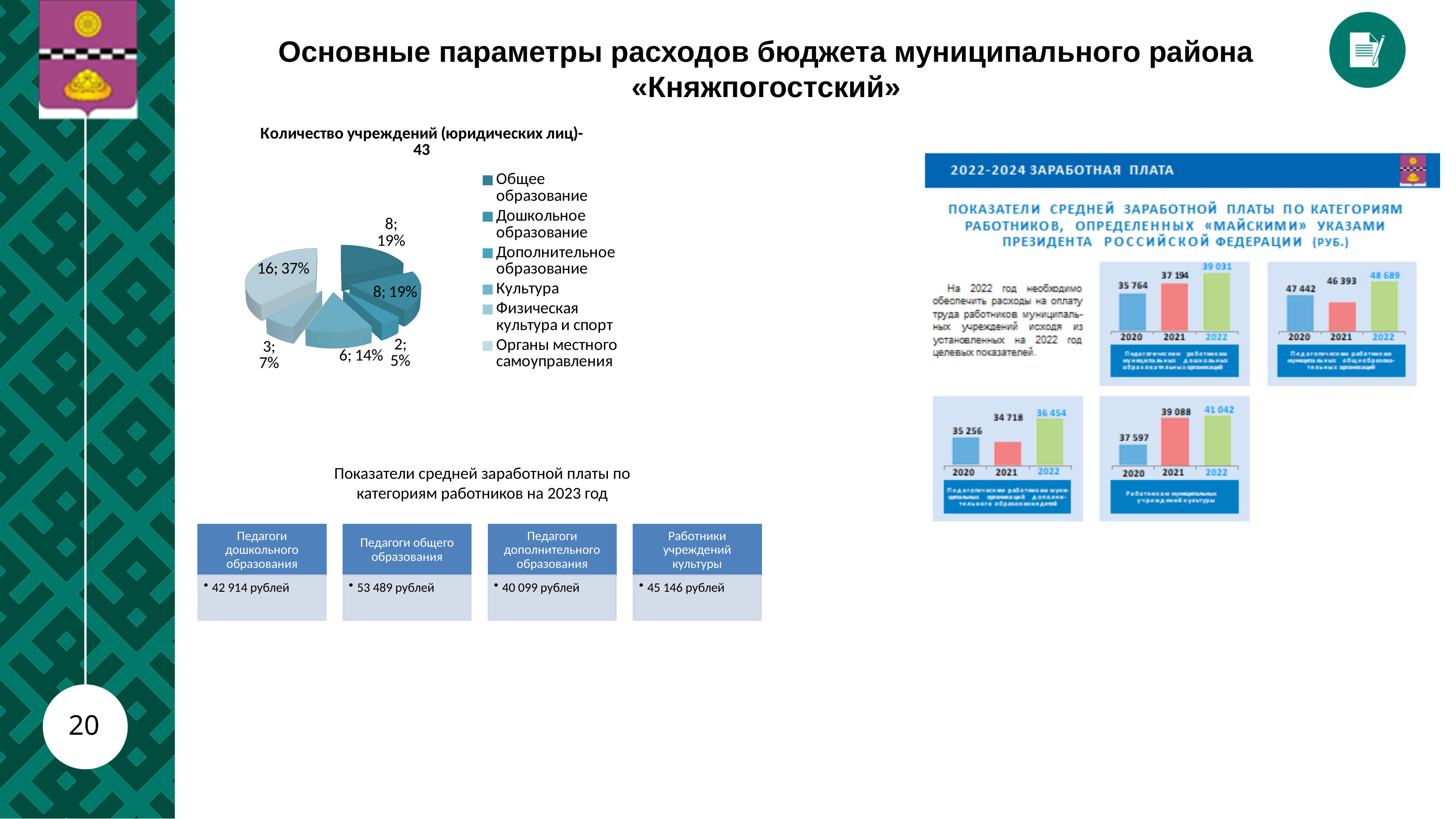
In the pie chart 'Количество учреждений (юридических лиц)- 43', which category has the largest number of institutions? Органы местного самоуправления In the pie chart 'Количество учреждений (юридических лиц)- 43', which category has the smallest number of institutions? Дополнительное образование In the pie chart 'Количество учреждений (юридических лиц)- 43', how many institutions are in the 'Органы местного самоуправления' category? 16 In the top-left bar chart of the '2022-2024 ЗАРАБОТНАЯ ПЛАТА' panel (педагогические работники дошкольных образовательных организаций), what is the value for 2022? 39 031 In the pie chart 'Количество учреждений (юридических лиц)- 43', what share of institutions does 'Культура' account for? 14% What type of chart is used for 'Количество учреждений (юридических лиц)- 43'? Pie chart In the bottom-right bar chart of the '2022-2024 ЗАРАБОТНАЯ ПЛАТА' panel (работники муниципальных учреждений культуры), do the values rise or fall from 2020 to 2022? Rise In the pie chart 'Количество учреждений (юридических лиц)- 43', which has more institutions: 'Физическая культура и спорт' or 'Дополнительное образование'? Физическая культура и спорт In the pie chart 'Количество учреждений (юридических лиц)- 43', what is the share of 'Общее образование'? 19% In the top-right bar chart of the '2022-2024 ЗАРАБОТНАЯ ПЛАТА' panel (педагогические работники общеобразовательных организаций), which year has the lowest value? 2021 In the pie chart 'Количество учреждений (юридических лиц)- 43', what is the difference between the number of institutions in 'Органы местного самоуправления' and in 'Культура'? 10 In the pie chart 'Количество учреждений (юридических лиц)- 43', how many categories are shown in the legend? 6